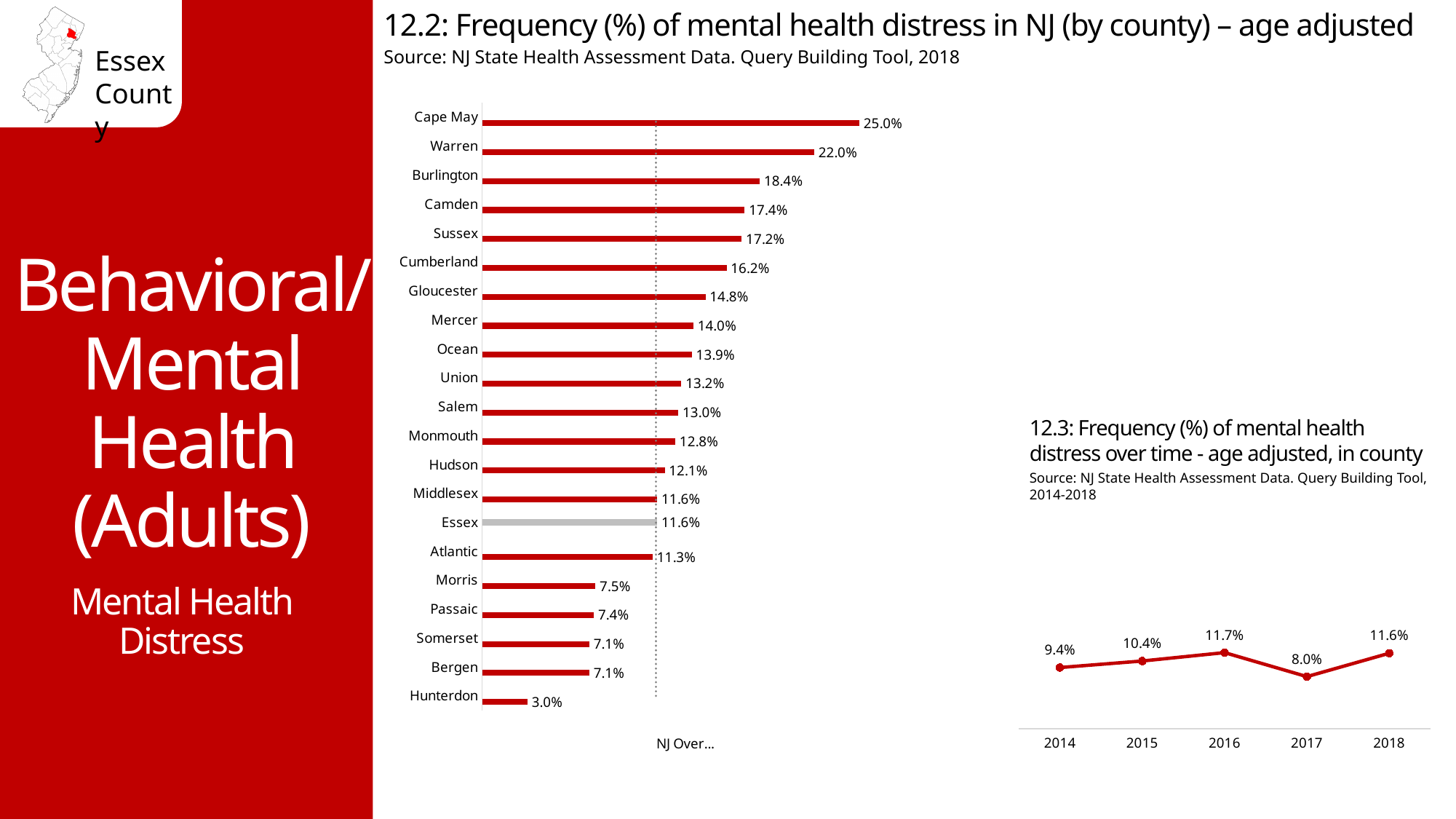
In chart 12.2 (frequency of mental health distress by county), how many counties are shown? 21 In chart 12.2 (frequency of mental health distress by county), what is the value for Essex? 11.6% In chart 12.2 (frequency of mental health distress by county), what is the value for Hudson? 12.1% In chart 12.3 (frequency of mental health distress over time), which year has the highest value? 2016 What kind of chart is chart 12.2 (frequency of mental health distress by county)? Bar chart In chart 12.2 (frequency of mental health distress by county), which county has the highest value? Cape May In chart 12.2 (frequency of mental health distress by county), which is larger, the value for Camden or the value for Sussex? Camden In chart 12.3 (frequency of mental health distress over time), what is the difference between 2018 and 2017? 3.6% In chart 12.2 (frequency of mental health distress by county), what is the difference between Cape May and Warren? 3.0% In chart 12.3 (frequency of mental health distress over time), what is the value for 2017? 8.0% In chart 12.2 (frequency of mental health distress by county), which county has the lowest value? Hunterdon What kind of chart is chart 12.3 (frequency of mental health distress over time)? Line chart